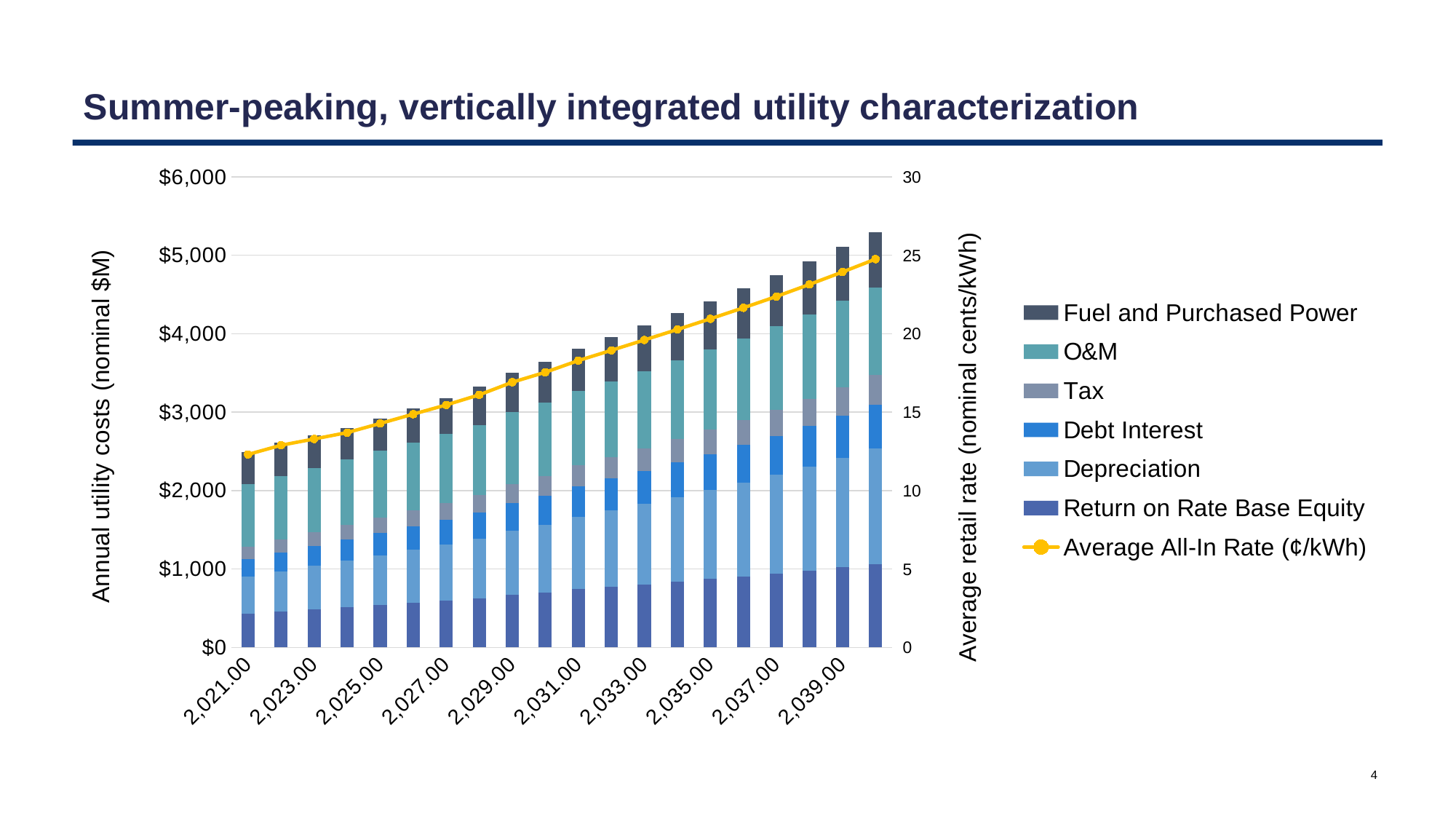
Is the total annual utility cost for 2021 greater or less than $3,000? less Which legend entry is represented by the yellow line with markers? Average All-In Rate (¢/kWh) Is the Average All-In Rate for the last year plotted greater or less than 20 cents/kWh? greater How many series does the legend list? 7 Is the total annual utility cost for the last bar (2040) greater or less than $5,000? greater Does the Average All-In Rate line rise or fall from 2021 to 2040? Rises What is the label of the right-hand vertical axis? Average retail rate (nominal cents/kWh) How many bars (years) are plotted in the chart? 20 Which year has the tallest stacked bar for annual utility costs? 2040 (the last bar) What kind of chart is shown on the slide? A stacked bar chart with a line overlay Which year has the shortest stacked bar for annual utility costs? 2021 (the first bar)